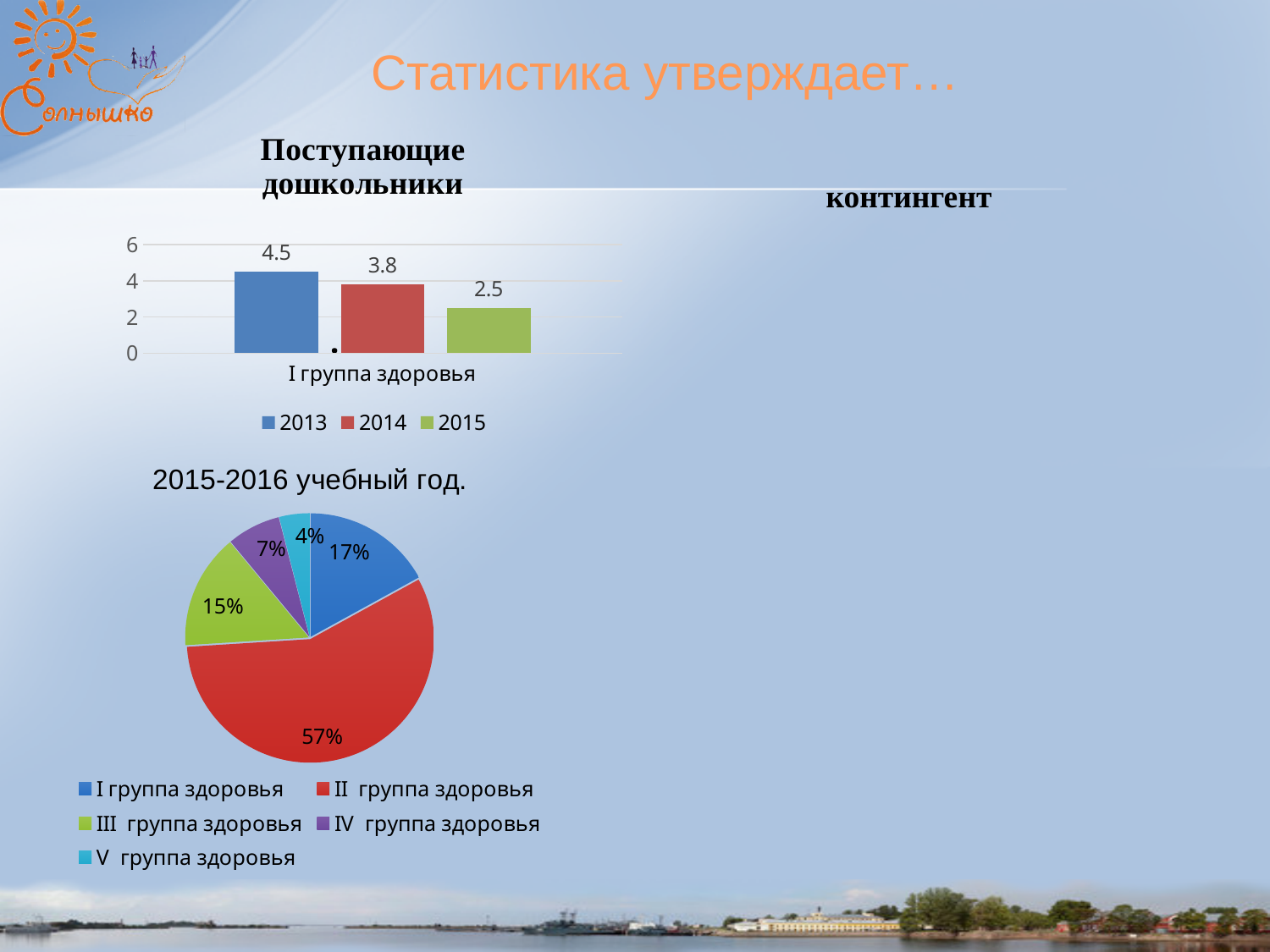
In the bar chart 'Поступающие дошкольники', what is the value for 2015? 2.5 In the bar chart 'Поступающие дошкольники', which year has the highest value? 2013 In the bar chart 'Поступающие дошкольники', what is the value for 2013? 4.5 In the bar chart 'Поступающие дошкольники', how many series does the legend list? 3 In the pie chart '2015-2016 учебный год.', how many slices are there? 5 In the pie chart '2015-2016 учебный год.', what share does 'II группа здоровья' have? 57% What kind of chart is the chart titled '2015-2016 учебный год.'? pie chart In the pie chart '2015-2016 учебный год.', which health group has the smallest share? V группа здоровья In the bar chart 'Поступающие дошкольники', what is the difference between the 2013 and 2014 values? 0.7 In the bar chart 'Поступающие дошкольники', does the value for 2014 rise or fall compared with 2013? fall In the pie chart '2015-2016 учебный год.', which is larger: 'I группа здоровья' or 'III группа здоровья'? I группа здоровья In the bar chart 'Поступающие дошкольники', which year has the lowest value? 2015